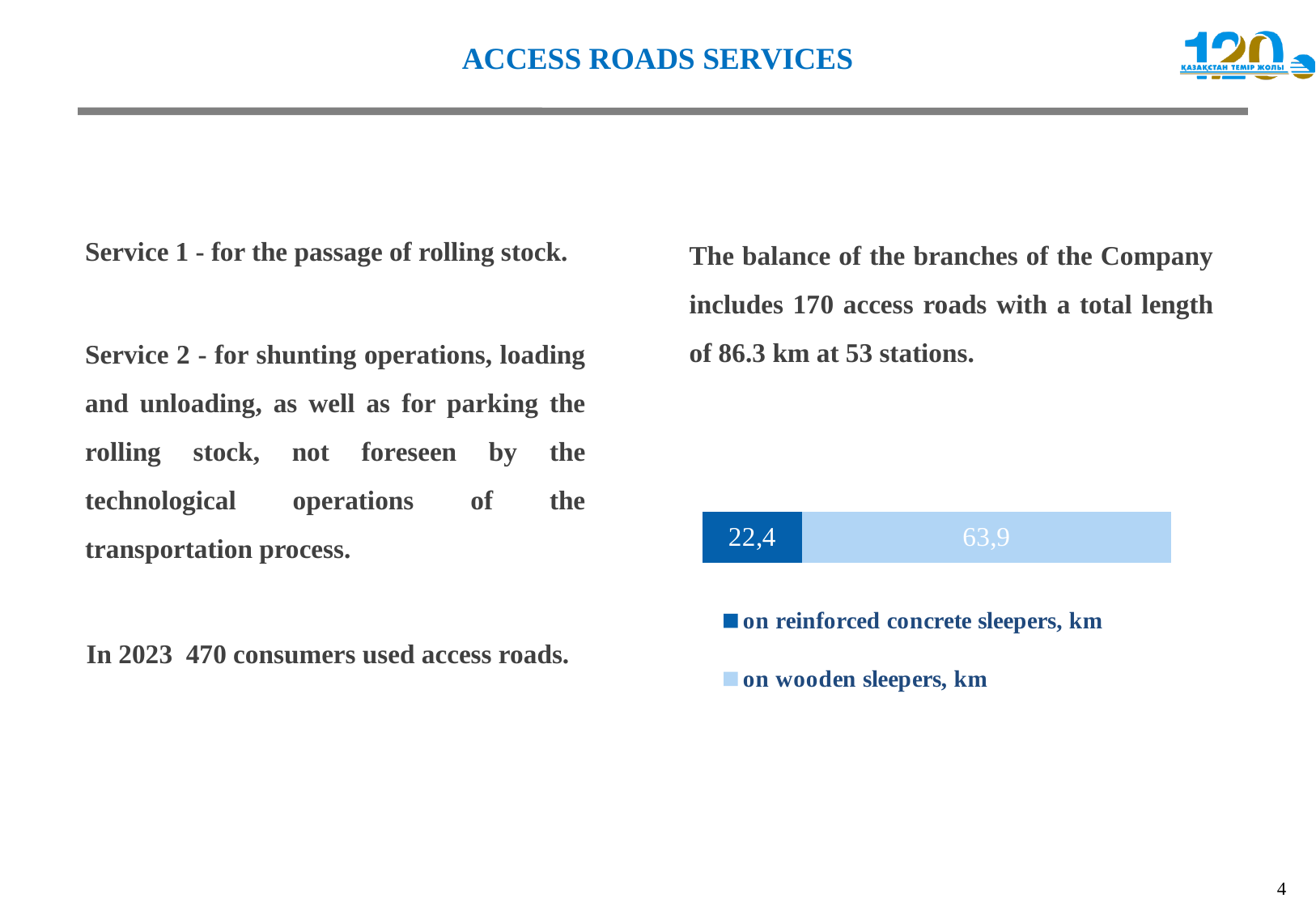
What is the value for access roads on wooden sleepers, km? 63,9 Which legend entry is shown in light blue? on wooden sleepers, km How many series does the legend list? 2 How many segments make up the bar in the chart? 2 What is the total length shown by the stacked bar? 86,3 What is the value for access roads on reinforced concrete sleepers, km? 22,4 Which legend entry is shown in dark blue? on reinforced concrete sleepers, km Which series has the largest value in the chart? on wooden sleepers, km What kind of chart is shown on the slide? stacked bar chart What is the difference between the value for wooden sleepers and the value for reinforced concrete sleepers? 41,5 Which series has the smallest value in the chart? on reinforced concrete sleepers, km Which series has the larger value, on reinforced concrete sleepers or on wooden sleepers? on wooden sleepers, km